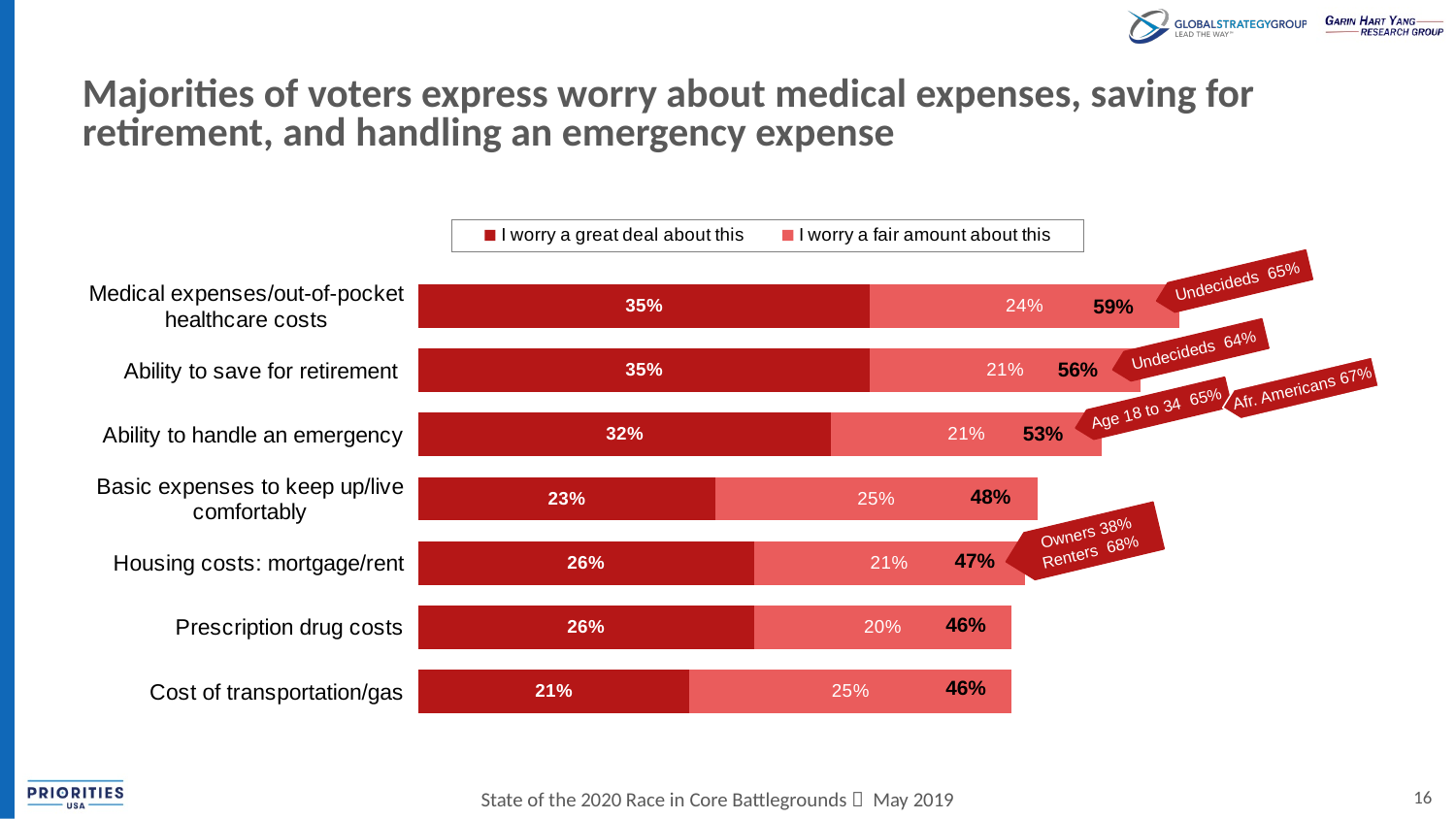
Which is larger: the 'I worry a fair amount about this' value for 'Basic expenses to keep up/live comfortably' or for 'Prescription drug costs'? Basic expenses to keep up/live comfortably What percentage of voters say they worry a fair amount about the cost of transportation/gas? 25% How many series does the legend list? 2 Which category has the lowest 'I worry a great deal about this' value? Cost of transportation/gas What is the combined total shown for 'Ability to handle an emergency'? 53% What is the difference between the 'I worry a great deal about this' values for 'Ability to save for retirement' and 'Housing costs: mortgage/rent'? 9 percentage points What kind of chart is shown on the slide? Stacked bar chart Which category has the highest combined total of voters who worry a great deal or a fair amount? Medical expenses/out-of-pocket healthcare costs What percentage of voters say they worry a great deal about medical expenses/out-of-pocket healthcare costs? 35% What is the title of the chart's slide? Majorities of voters express worry about medical expenses, saving for retirement, and handling an emergency expense How many categories are plotted in the chart? 7 What is the combined total shown for 'Housing costs: mortgage/rent'? 47%